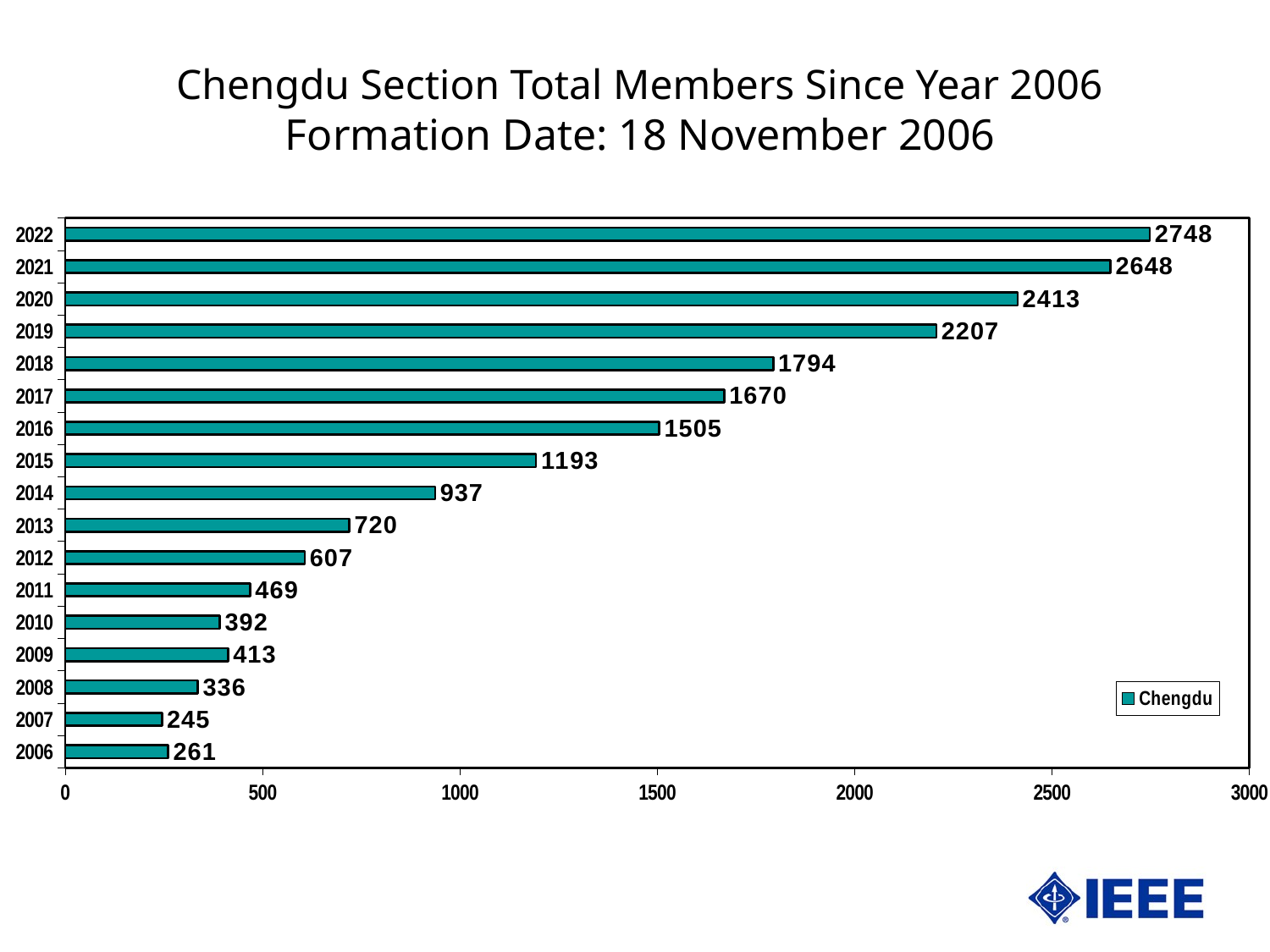
What is the difference in members between 2016 and 2015? 312 Which year has the highest number of members? 2022 Which year had more members, 2009 or 2010? 2009 What kind of chart is shown on the slide? Bar chart Is the value for 2018 greater or less than 1500? greater What was the total number of Chengdu Section members in 2019? 2207 Which year has the lowest number of members? 2007 How many series does the legend list? 1 How many years are shown in the chart? 17 What is the difference in members between 2022 and 2021? 100 What is the name of the series shown in the legend? Chengdu What was the total number of Chengdu Section members in 2012? 607